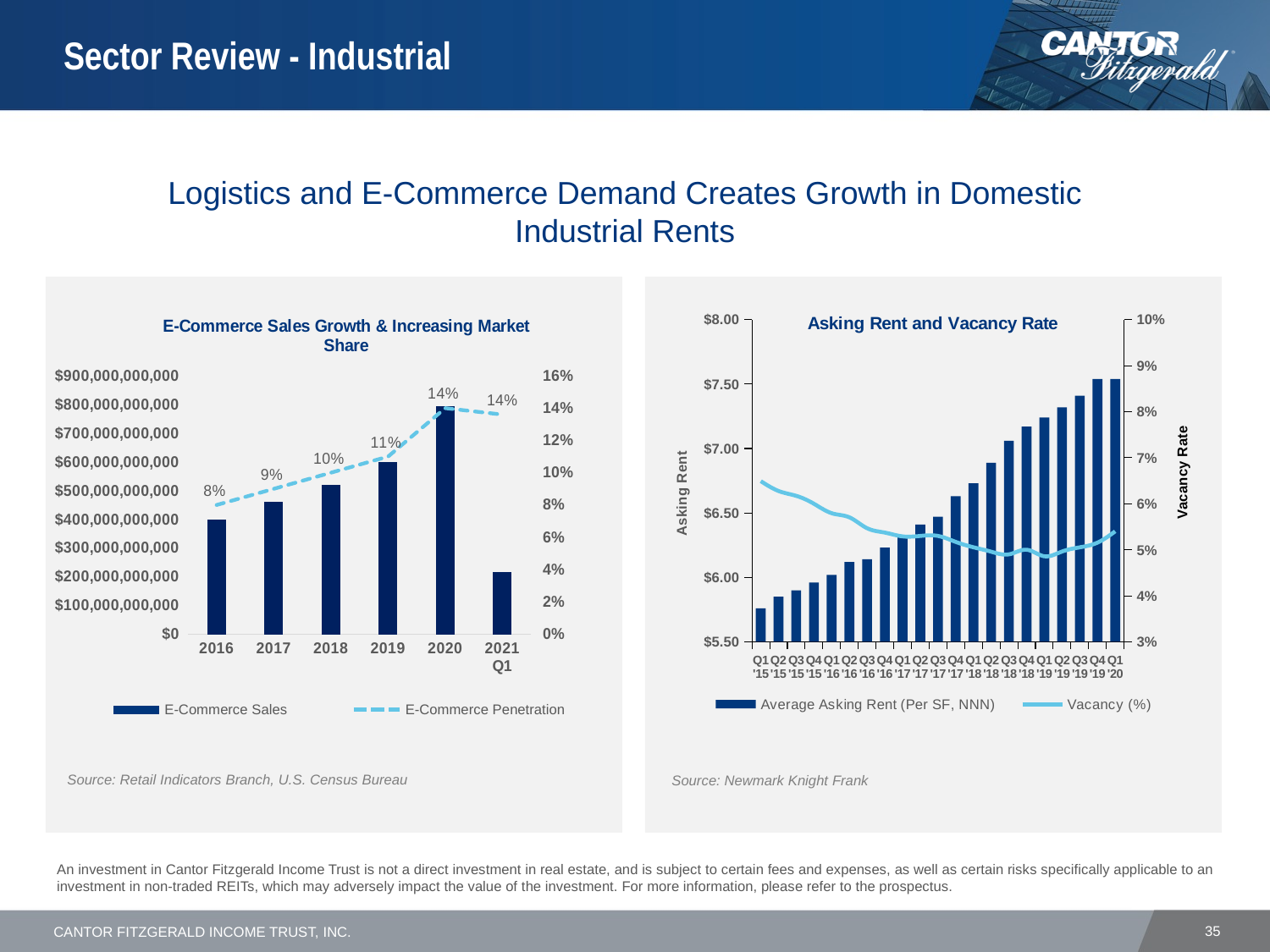
How many time periods are shown on the x axis of the E-Commerce Sales Growth & Increasing Market Share chart? 6 In the E-Commerce Sales Growth & Increasing Market Share chart, what is the E-Commerce Penetration value for 2020? 14% In the Asking Rent and Vacancy Rate chart, what kind of chart is used to show Average Asking Rent? bar chart In the E-Commerce Sales Growth & Increasing Market Share chart, what is the E-Commerce Penetration value for 2016? 8% In the E-Commerce Sales Growth & Increasing Market Share chart, which period has the highest E-Commerce Sales bar? 2020 In the Asking Rent and Vacancy Rate chart, is the Vacancy rate for Q1 '15 greater or less than 6%? greater How many series does the legend of the E-Commerce Sales Growth & Increasing Market Share chart list? 2 In the Asking Rent and Vacancy Rate chart, does the Average Asking Rent rise or fall from Q1 '15 to Q1 '20? rise In the E-Commerce Sales Growth & Increasing Market Share chart, is the E-Commerce Sales value for 2020 greater or less than $700,000,000,000? greater In the Asking Rent and Vacancy Rate chart, is the Average Asking Rent for Q1 '15 greater or less than $6.00? less In the E-Commerce Sales Growth & Increasing Market Share chart, what is the difference between the E-Commerce Penetration values for 2019 and 2016? 3% In the E-Commerce Sales Growth & Increasing Market Share chart, which period has the lowest E-Commerce Sales bar? 2021 Q1